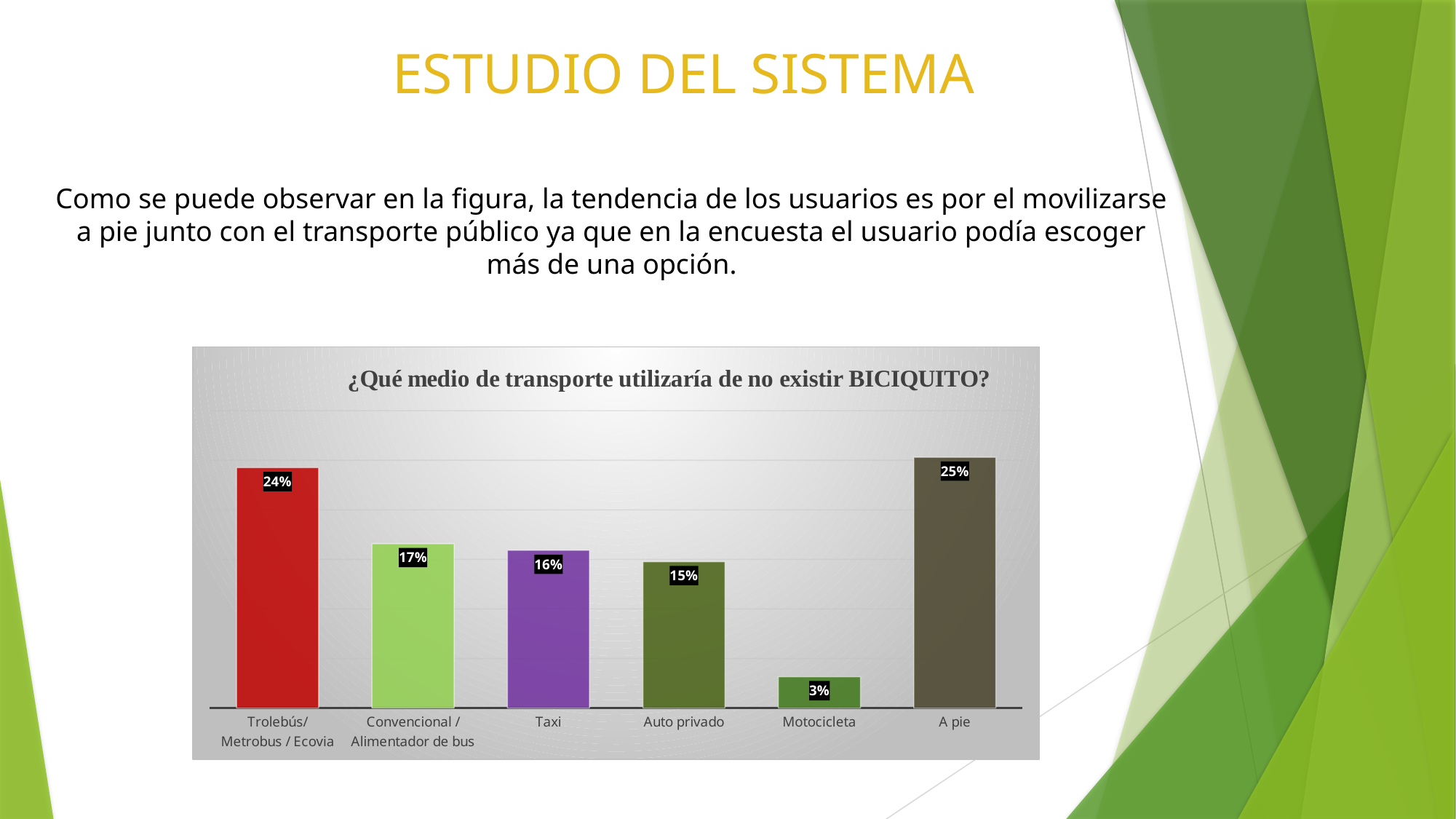
What is the title of the chart? ¿Qué medio de transporte utilizaría de no existir BICIQUITO? What kind of chart is shown on the slide? Bar chart What is the value for Taxi? 16% Which is larger, the value for Convencional / Alimentador de bus or the value for Auto privado? Convencional / Alimentador de bus How many categories are shown in the chart? 6 What is the difference between the values for Convencional / Alimentador de bus and Motocicleta? 14% What is the value for Trolebús/ Metrobus / Ecovia? 24% What is the value for Motocicleta? 3% What is the value for A pie? 25% Which category has the lowest value? Motocicleta Which category has the highest value? A pie What is the difference between the values for A pie and Auto privado? 10%